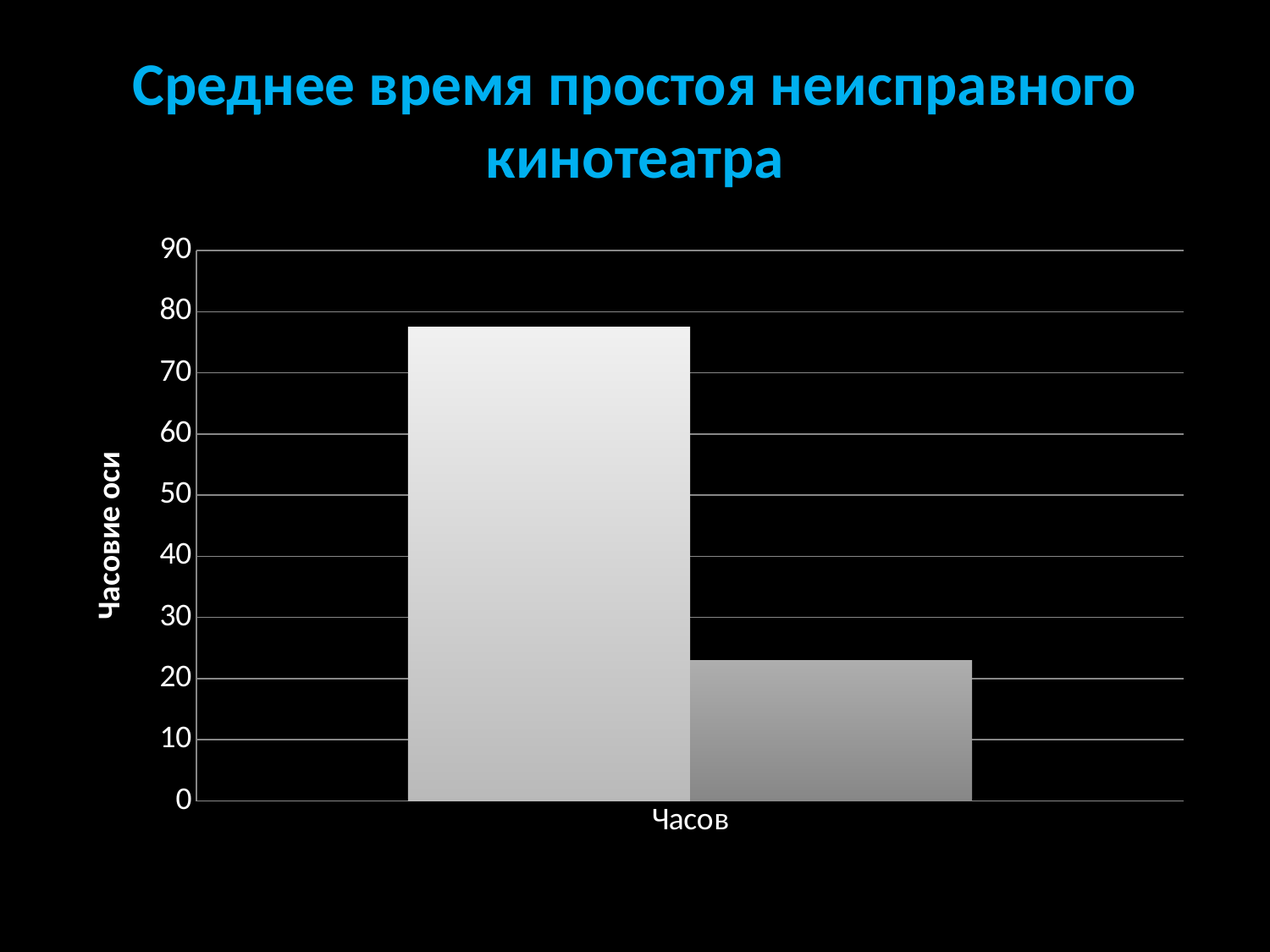
What is the title of the chart? Среднее время простоя неисправного кинотеатра Which bar is taller, the left (lighter) bar or the right (darker) bar? the left (lighter) bar Is the value of the left (lighter) bar greater or less than 70? greater Is the value of the left (lighter) bar greater or less than 80? less What is the label on the vertical axis of the chart? Часовие оси How many categories are shown on the horizontal axis? 1 How many bars are plotted in the chart? 2 Is the value of the right (darker) bar greater or less than 30? less Which bar has the lowest value, the left (lighter) bar or the right (darker) bar? the right (darker) bar What is the highest tick value shown on the vertical axis? 90 What kind of chart is shown on the slide? bar chart